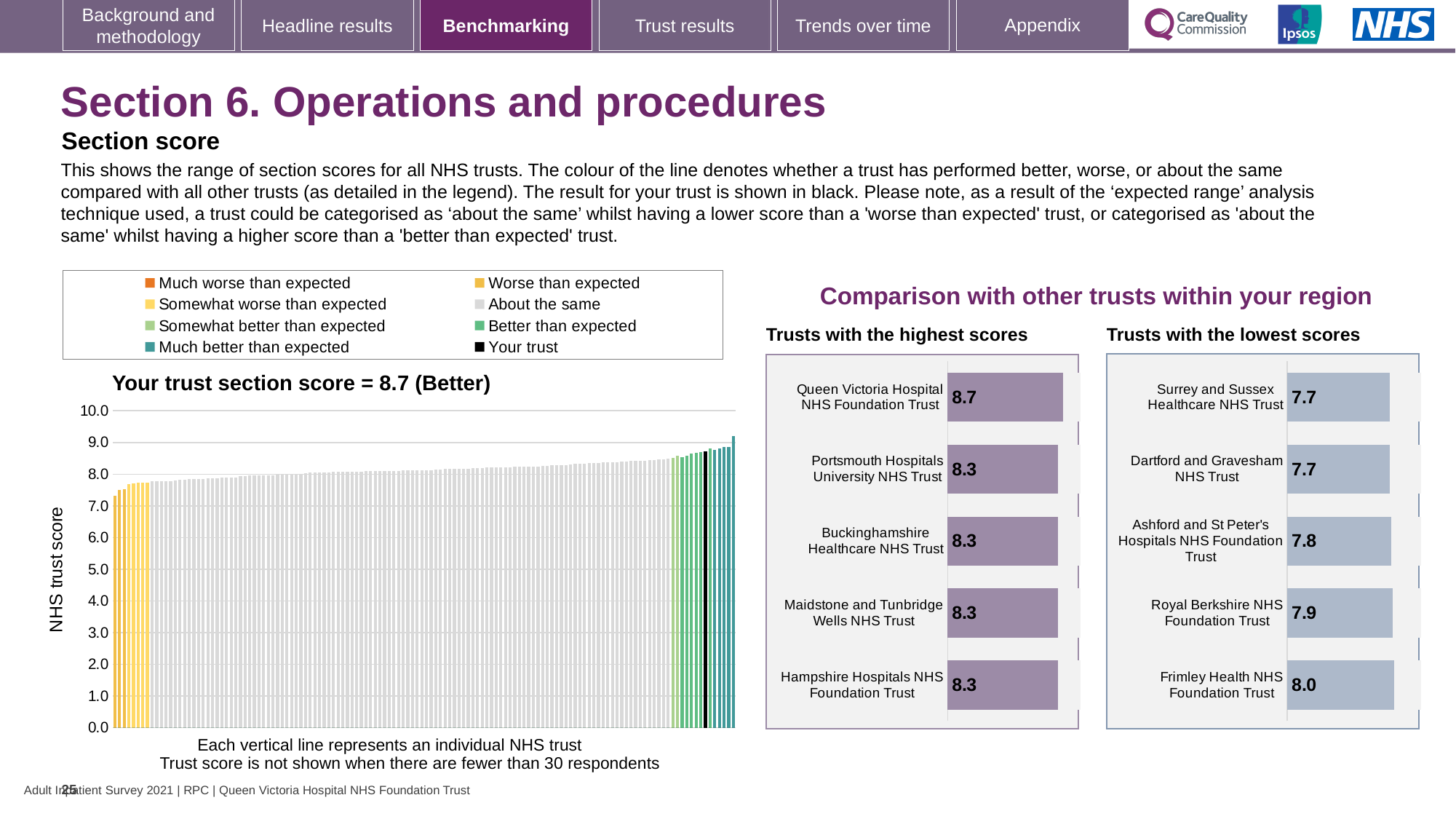
What kind of chart is the 'Your trust section score' chart? bar chart In the 'Trusts with the lowest scores' chart, what is the score for Ashford and St Peter's Hospitals NHS Foundation Trust? 7.8 In the 'Your trust section score' chart, do the bars rise or fall from left to right? rise In the 'Your trust section score' chart, is the value of the lowest bar greater or less than 7.0? greater In the 'Trusts with the highest scores' chart, what is the difference between the scores of Queen Victoria Hospital NHS Foundation Trust and Hampshire Hospitals NHS Foundation Trust? 0.4 In the 'Trusts with the highest scores' chart, which trust has the highest score? Queen Victoria Hospital NHS Foundation Trust How many trusts are shown in the 'Trusts with the lowest scores' chart? 5 What is the y-axis label of the 'Your trust section score' chart? NHS trust score How many entries does the legend above the 'Your trust section score' chart list? 8 In the 'Your trust section score' chart, what is the section score for your trust? 8.7 In the 'Trusts with the highest scores' chart, what is the score for Portsmouth Hospitals University NHS Trust? 8.3 In the 'Trusts with the lowest scores' chart, which has the larger score: Royal Berkshire NHS Foundation Trust or Surrey and Sussex Healthcare NHS Trust? Royal Berkshire NHS Foundation Trust